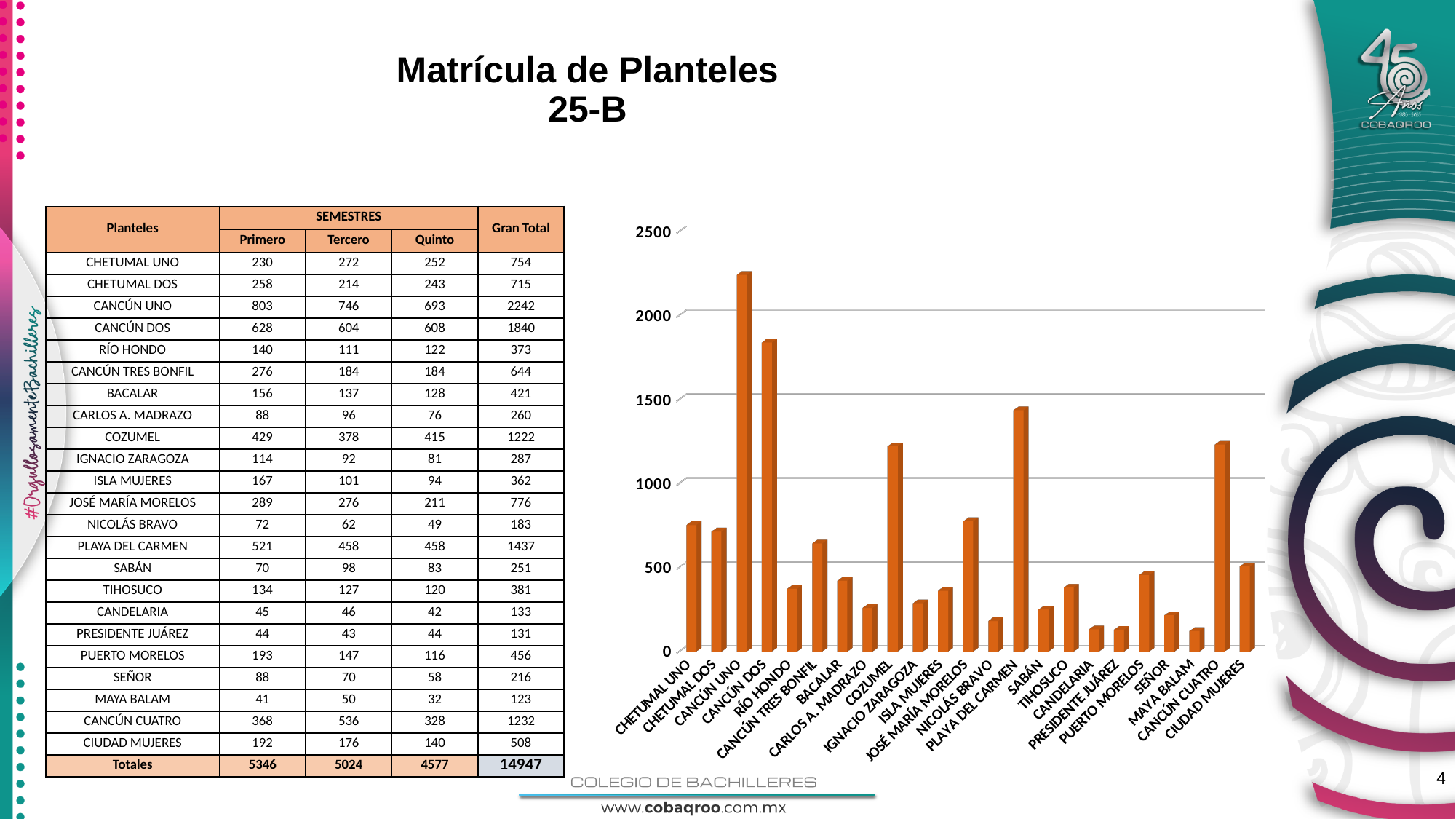
Is the bar for COZUMEL greater or less than 1000? greater Which bar is taller, CANCÚN UNO or CANCÚN CUATRO? CANCÚN UNO What kind of chart is shown on the slide? bar chart How many planteles (categories) are plotted in the bar chart? 23 Which plantel has the tallest bar in the chart? CANCÚN UNO Is the bar for CANCÚN DOS greater or less than 1500? greater Which bar is taller, CANCÚN DOS or PLAYA DEL CARMEN? CANCÚN DOS Is the bar for PLAYA DEL CARMEN greater or less than 1500? less What is the highest value shown on the chart's vertical axis? 2500